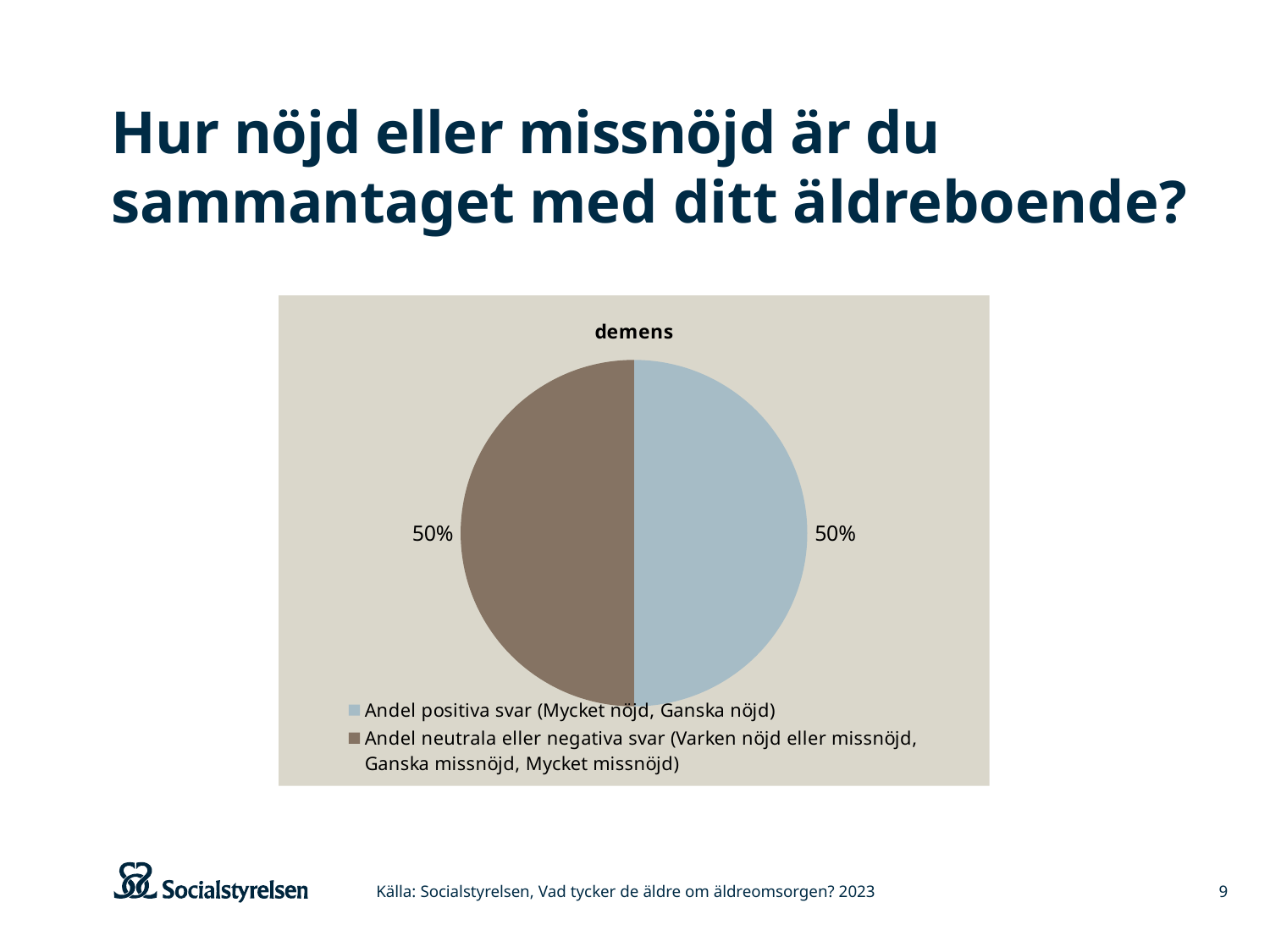
What is the difference between the 'Andel positiva svar' slice and the 'Andel neutrala eller negativa svar' slice? 0% What share of the pie is 'Andel positiva svar (Mycket nöjd, Ganska nöjd)'? 50% Which colour represents 'Andel positiva svar (Mycket nöjd, Ganska nöjd)' in the chart? light blue What value is shown for the 'Andel positiva svar' slice? 50% What value is shown for the 'Andel neutrala eller negativa svar' slice? 50% What kind of chart is shown on the slide? pie chart What share of the pie is 'Andel neutrala eller negativa svar (Varken nöjd eller missnöjd, Ganska missnöjd, Mycket missnöjd)'? 50% What is the title of the chart? demens How many entries does the chart legend list? 2 What is the total of the two slices shown in the pie chart? 100% How many slices does the pie chart have? 2